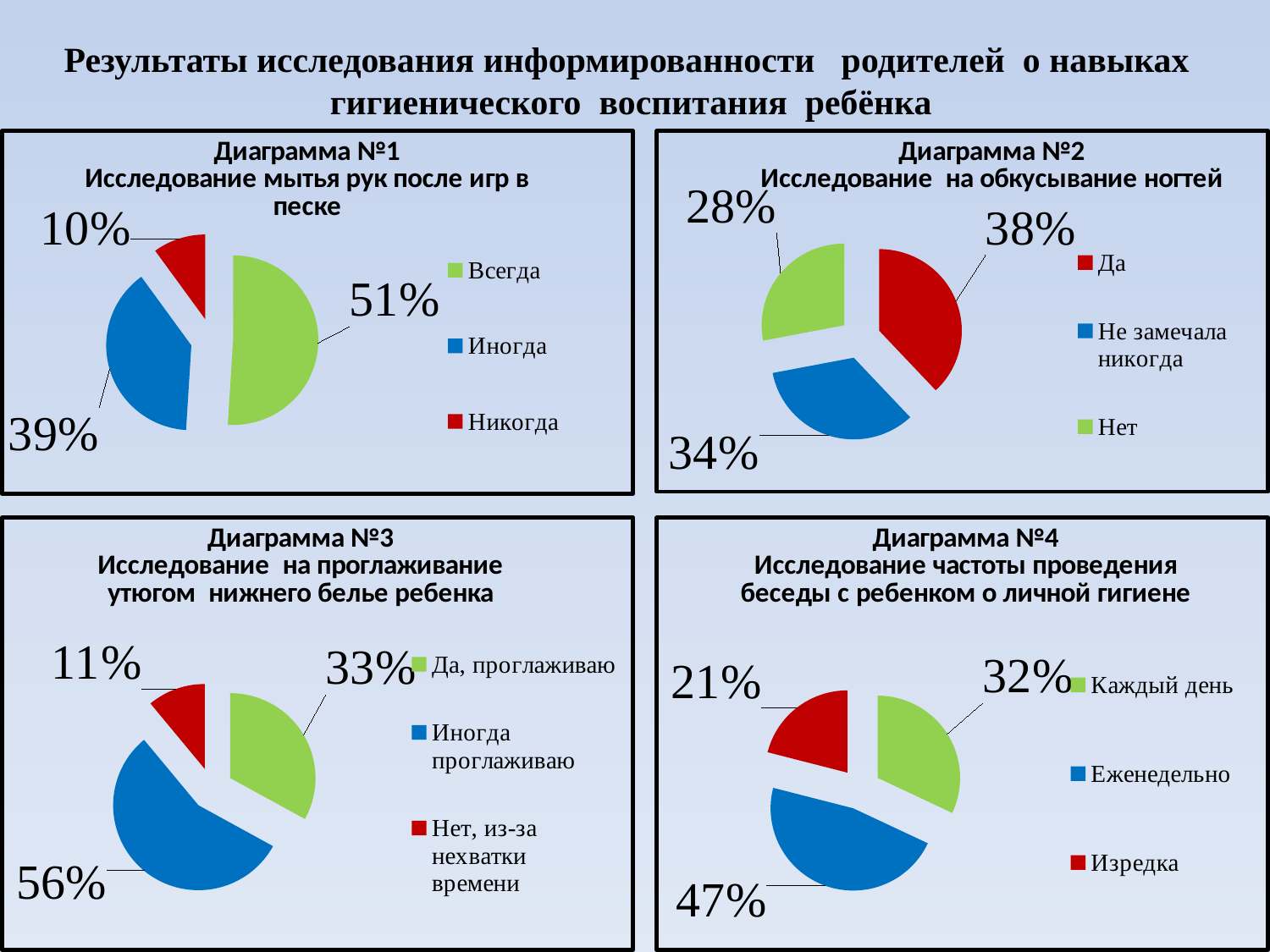
In Диаграмма №3 (Исследование на проглаживание утюгом нижнего белье ребенка), what percentage is shown for «Иногда проглаживаю»? 56% In Диаграмма №1, what is the difference between the shares for «Иногда» and «Никогда»? 29% How many categories does the legend of Диаграмма №4 list? 3 In Диаграмма №2 (Исследование на обкусывание ногтей), what percentage is shown for «Не замечала никогда»? 34% What type of chart is Диаграмма №3? Pie chart In Диаграмма №4 (Исследование частоты проведения беседы с ребенком о личной гигиене), what percentage is shown for «Изредка»? 21% In Диаграмма №2, which is larger: the share for «Нет» or the share for «Не замечала никогда»? Не замечала никогда In Диаграмма №3, what is the difference between the shares for «Да, проглаживаю» and «Нет, из-за нехватки времени»? 22% In Диаграмма №1 (Исследование мытья рук после игр в песке), what percentage is shown for «Всегда»? 51% In Диаграмма №4, which category has the largest share? Еженедельно In Диаграмма №2, which category has the largest share? Да In Диаграмма №1, which category has the smallest share? Никогда